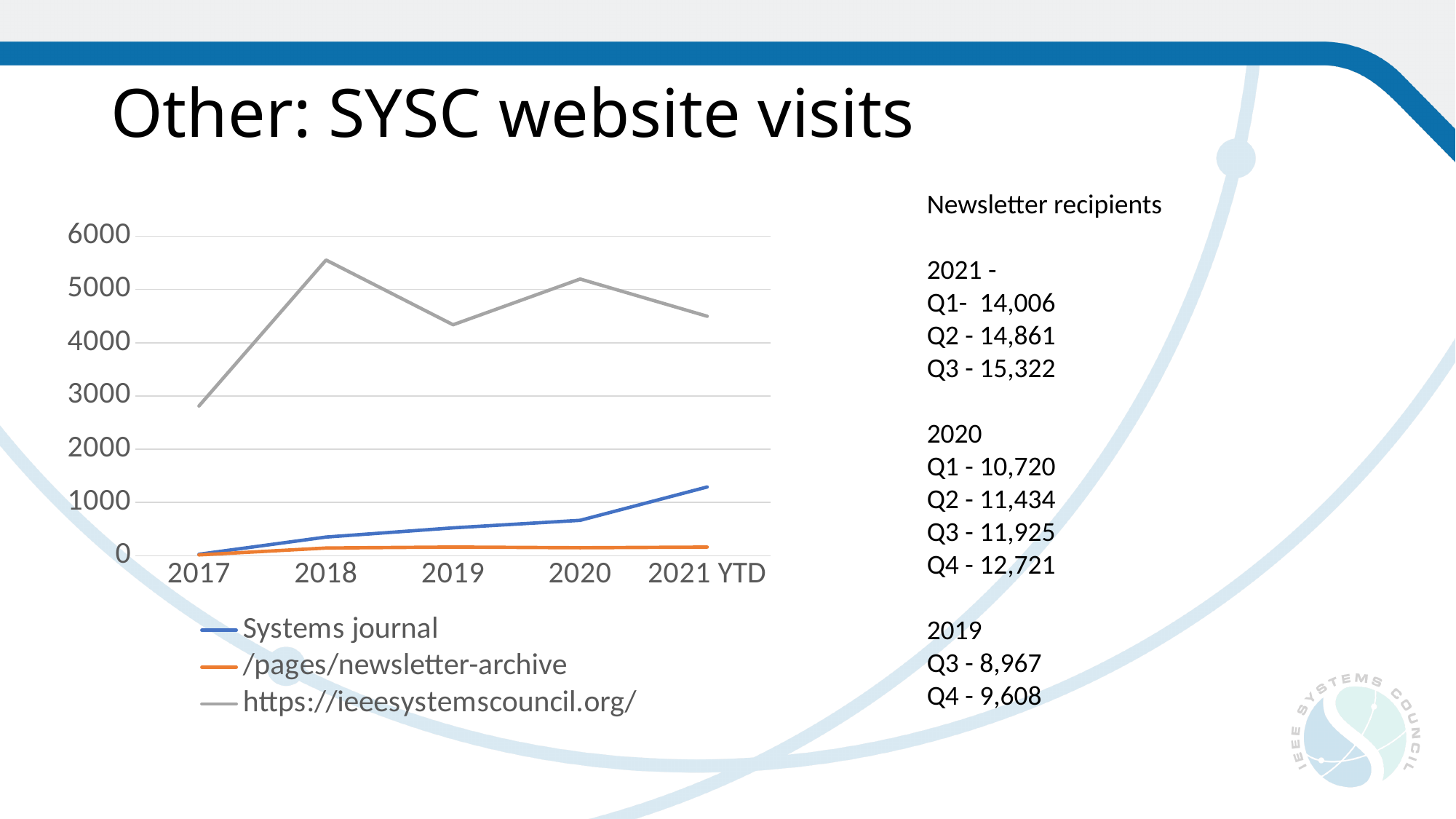
How many points along the x axis does the chart show? 5 What kind of chart is shown on the slide? Line chart In which year does the https://ieeesystemscouncil.org/ series reach its highest value? 2018 Is the value for https://ieeesystemscouncil.org/ in 2017 greater or less than 3000? less Does the Systems journal series rise or fall from 2017 to 2021 YTD? Rise Which colour is used for the /pages/newsletter-archive series? Orange Is the value for Systems journal in 2020 greater or less than 1000? less Is the value for https://ieeesystemscouncil.org/ in 2018 greater or less than 5000? greater In 2020, which series has the larger value: Systems journal or https://ieeesystemscouncil.org/? https://ieeesystemscouncil.org/ How many series does the chart legend list? 3 In which year is the https://ieeesystemscouncil.org/ series at its lowest value? 2017